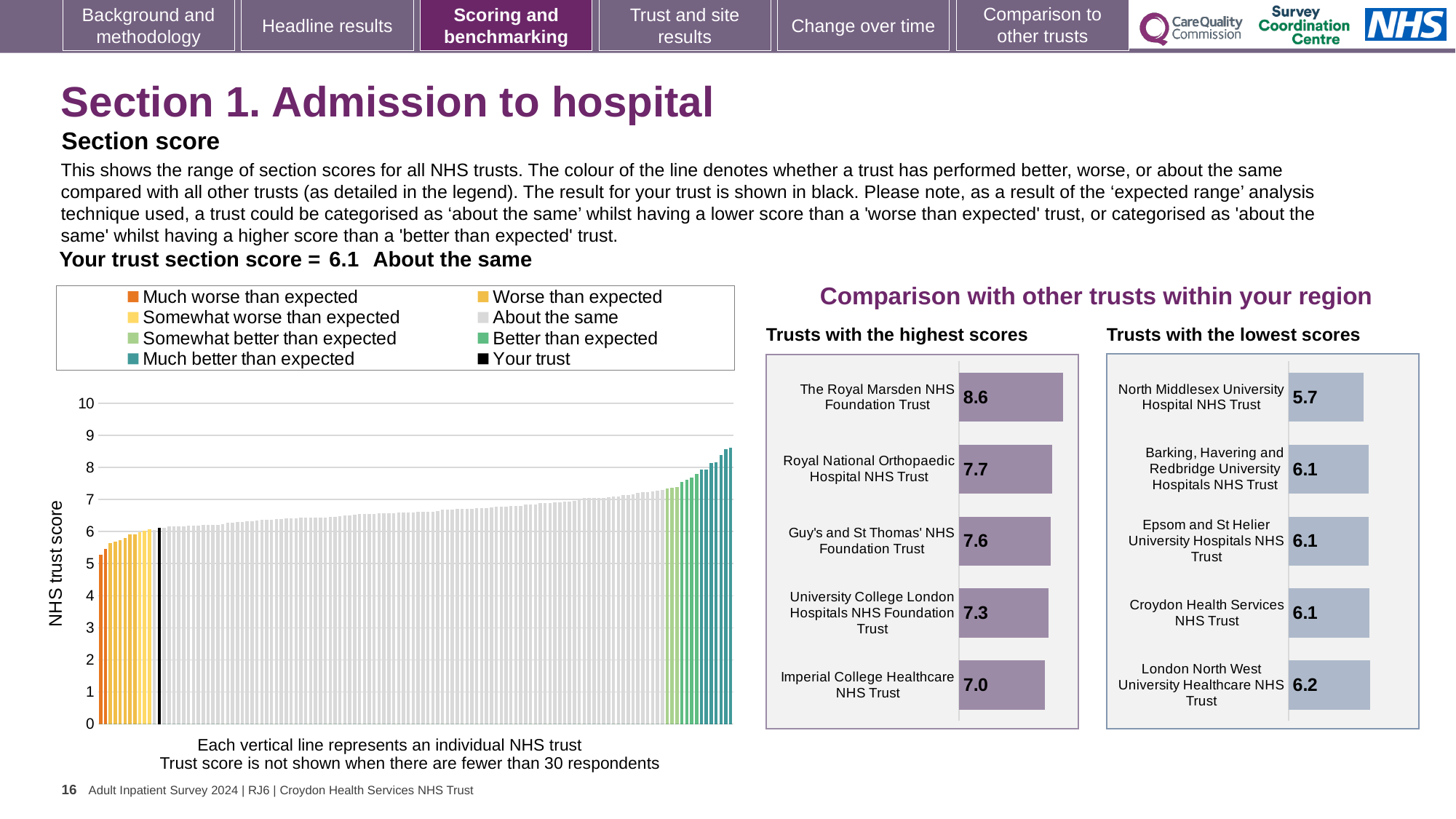
In the 'Trusts with the highest scores' chart, what is the score for The Royal Marsden NHS Foundation Trust? 8.6 In the 'Trusts with the lowest scores' chart, which trust has the lowest score? North Middlesex University Hospital NHS Trust What is the label on the vertical axis of the left-hand section score chart? NHS trust score In the 'Trusts with the highest scores' chart, which has the higher score: Royal National Orthopaedic Hospital NHS Trust or Guy's and St Thomas' NHS Foundation Trust? Royal National Orthopaedic Hospital NHS Trust How many entries does the legend of the left-hand section score chart list? 8 In the 'Trusts with the lowest scores' chart, what is the score for North Middlesex University Hospital NHS Trust? 5.7 How many trusts are shown in the 'Trusts with the highest scores' chart? 5 In the left-hand section score chart, what is the section score for your trust (shown in black)? 6.1 In the 'Trusts with the lowest scores' chart, what is the difference between the scores of London North West University Healthcare NHS Trust and North Middlesex University Hospital NHS Trust? 0.5 In the 'Trusts with the highest scores' chart, which trust has the highest score? The Royal Marsden NHS Foundation Trust What kind of chart is the large chart on the left showing the range of section scores for all NHS trusts? Bar chart In the 'Trusts with the highest scores' chart, what is the difference between the scores of The Royal Marsden NHS Foundation Trust and Imperial College Healthcare NHS Trust? 1.6